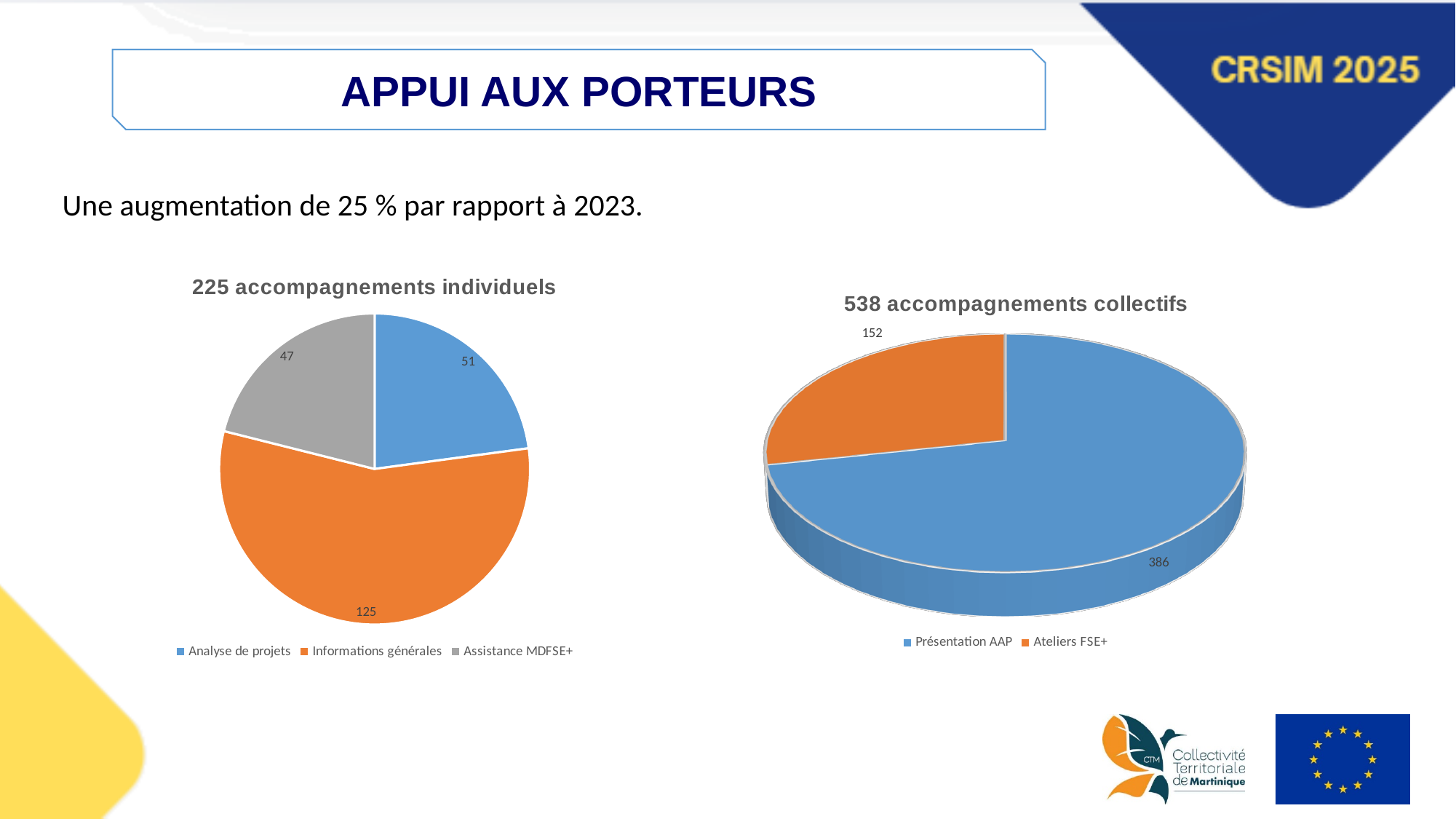
What type of chart is the '538 accompagnements collectifs' chart? Pie chart In the '225 accompagnements individuels' chart, what is the value for Assistance MDFSE+? 47 In the '225 accompagnements individuels' chart, which category has the smallest slice? Assistance MDFSE+ In the '538 accompagnements collectifs' chart, which is larger, Présentation AAP or Ateliers FSE+? Présentation AAP In the '538 accompagnements collectifs' chart, what is the difference between Présentation AAP and Ateliers FSE+? 234 In the '538 accompagnements collectifs' chart, what is the value for Ateliers FSE+? 152 In the '538 accompagnements collectifs' chart, what is the value for Présentation AAP? 386 In the '538 accompagnements collectifs' chart, how many entries does the legend list? 2 In the '225 accompagnements individuels' chart, what is the difference between Informations générales and Analyse de projets? 74 In the '225 accompagnements individuels' chart, how many categories are shown? 3 In the '225 accompagnements individuels' chart, which category has the largest slice? Informations générales In the '225 accompagnements individuels' chart, what is the value for Informations générales? 125